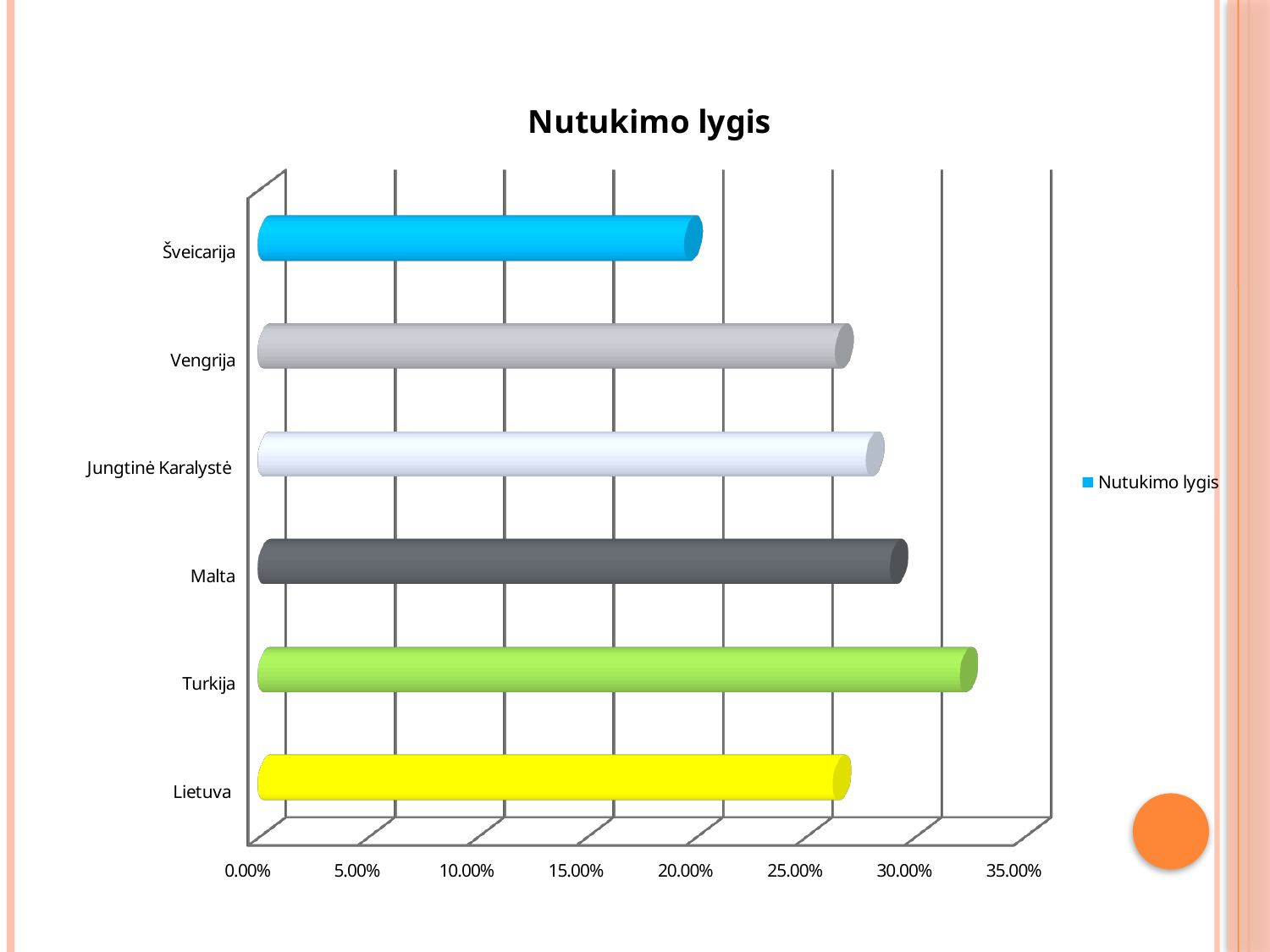
How many countries are shown in the chart? 6 What colour is the bar for Turkija? green Is the value for Šveicarija greater or less than 25.00%? less Which has the larger value, Malta or Vengrija? Malta What type of chart is shown on the slide? bar chart What is the title of the chart? Nutukimo lygis How many series does the legend list? 1 Which country has the lowest value in the chart? Šveicarija Which country has the highest value in the chart? Turkija Is the value for Vengrija greater or less than 25.00%? greater Is the value for Turkija greater or less than 30.00%? greater